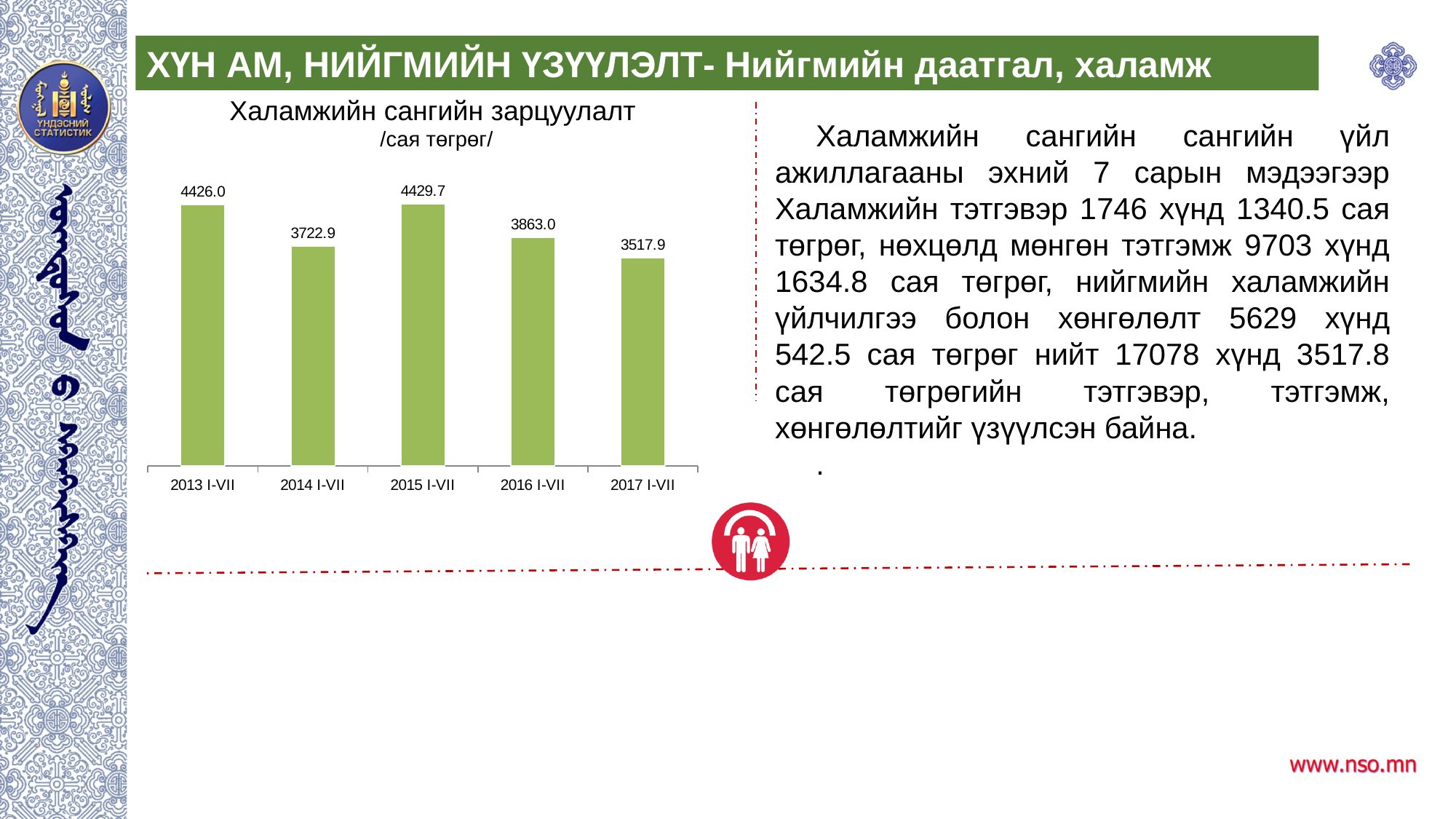
Which period has the highest value in the chart? 2015 I-VII Do the values rise or fall from 2015 I-VII to 2017 I-VII? fall What unit is given under the chart title? сая төгрөг Which period has the lowest value in the chart? 2017 I-VII What is the value for 2015 I-VII in the chart? 4429.7 What kind of chart is shown on the slide? bar chart How many periods are shown on the x axis of the chart? 5 What is the value for 2017 I-VII in the chart? 3517.9 What is the difference between the values for 2016 I-VII and 2017 I-VII? 345.1 What is the difference between the values for 2013 I-VII and 2014 I-VII? 703.1 Which is larger, the value for 2014 I-VII or the value for 2016 I-VII? 2016 I-VII What is the value for 2013 I-VII in the chart 'Халамжийн сангийн зарцуулалт'? 4426.0